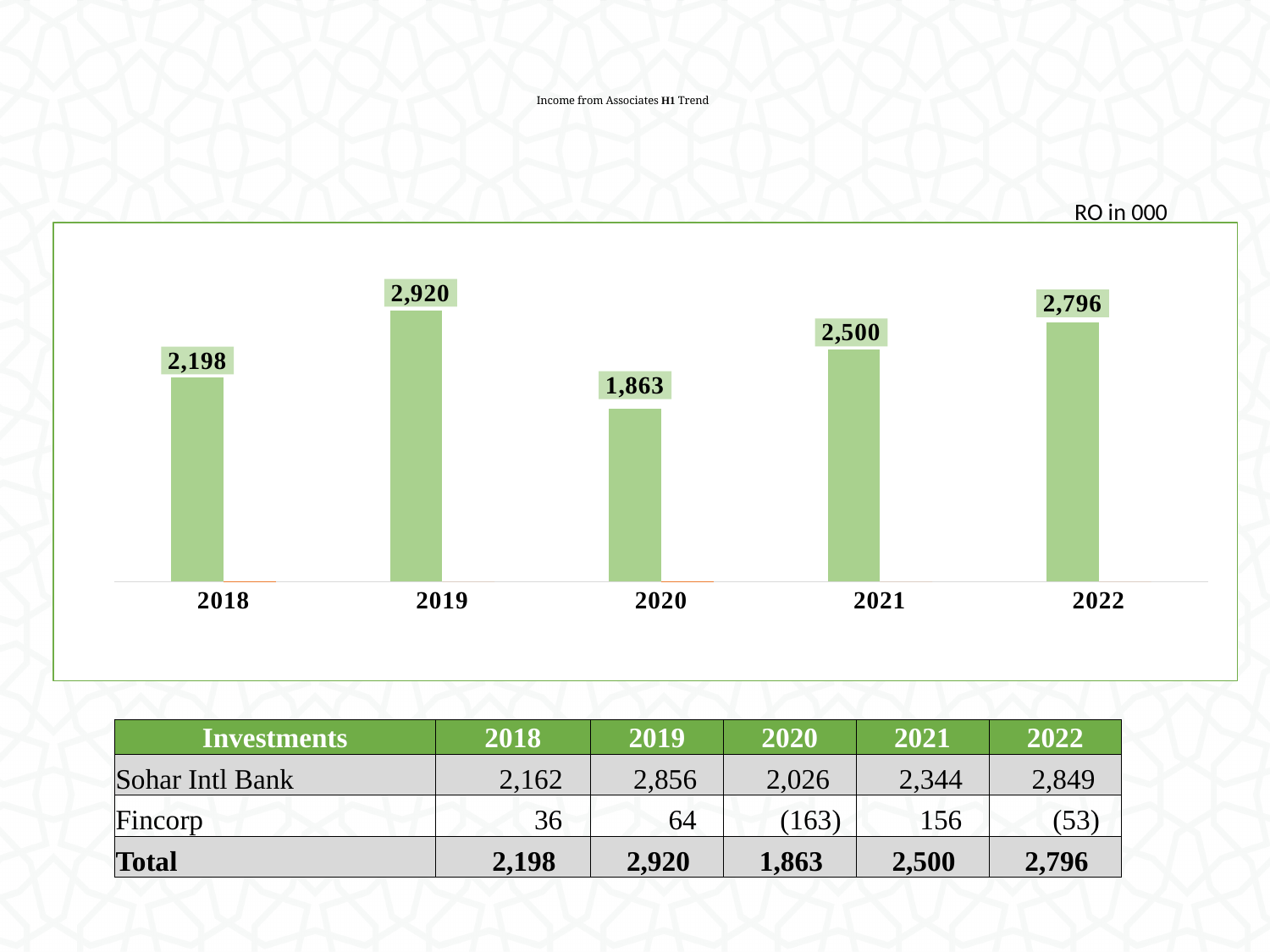
What is the value for 2022? 2,796 What kind of chart is shown on the slide? Bar chart What is the value for 2020? 1,863 What is the title of the chart? Income from Associates H1 Trend What is the difference between the values for 2022 and 2021? 296 How many years are shown on the chart? 5 What is the value for 2019? 2,920 Which is larger, the value for 2018 or the value for 2021? 2021 What is the difference between the values for 2019 and 2020? 1,057 Which year has the highest value? 2019 Does the value rise or fall from 2019 to 2020? Fall Which year has the lowest value? 2020